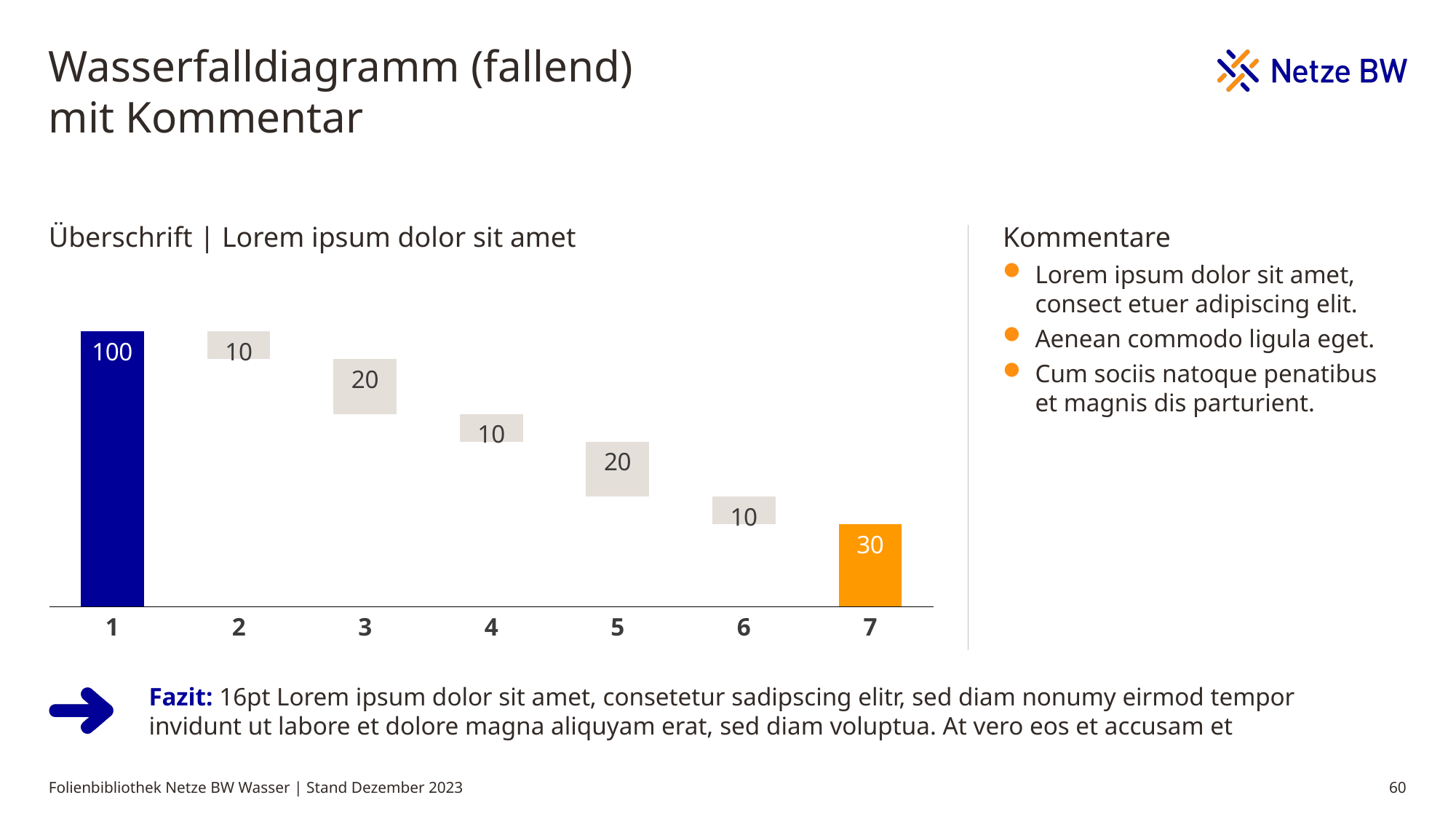
What kind of chart is shown on the slide? waterfall chart How many categories are shown on the x axis? 7 What is the title shown above the chart? Überschrift | Lorem ipsum dolor sit amet What is the value shown for category 7? 30 Do the bars rise or fall from category 1 to category 7? fall What is the value shown for category 6? 10 Which category has the highest value? 1 What is the value shown for category 3? 20 What is the value shown for category 1? 100 Which is larger, the value for category 7 or the value for category 5? category 7 What is the difference between the values for category 1 and category 7? 70 What is the difference between the values for category 3 and category 2? 10